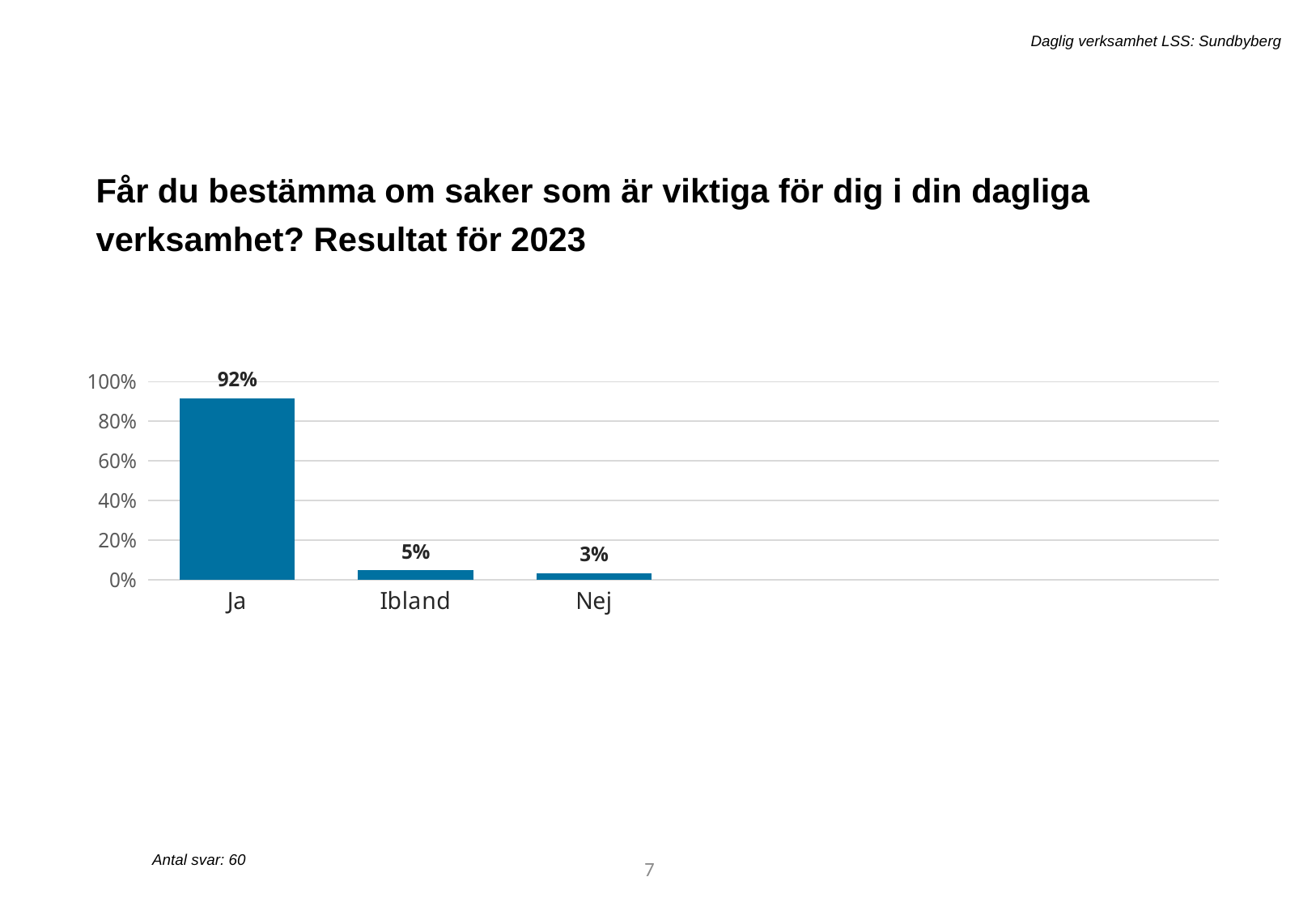
What is the value for Nej? 3% Which is larger, the value for Ibland or the value for Nej? Ibland Which category has the highest value? Ja How many categories are shown on the x axis? 3 What is the value for Ja? 92% What is the difference between the values for Ibland and Nej? 2% Which category has the lowest value? Nej What is the number of responses (Antal svar) stated on the slide? 60 What kind of chart is shown on the slide? bar chart What is the difference between the values for Ja and Ibland? 87% What is the value for Ibland? 5% Is the value for Ja greater or less than 80%? greater